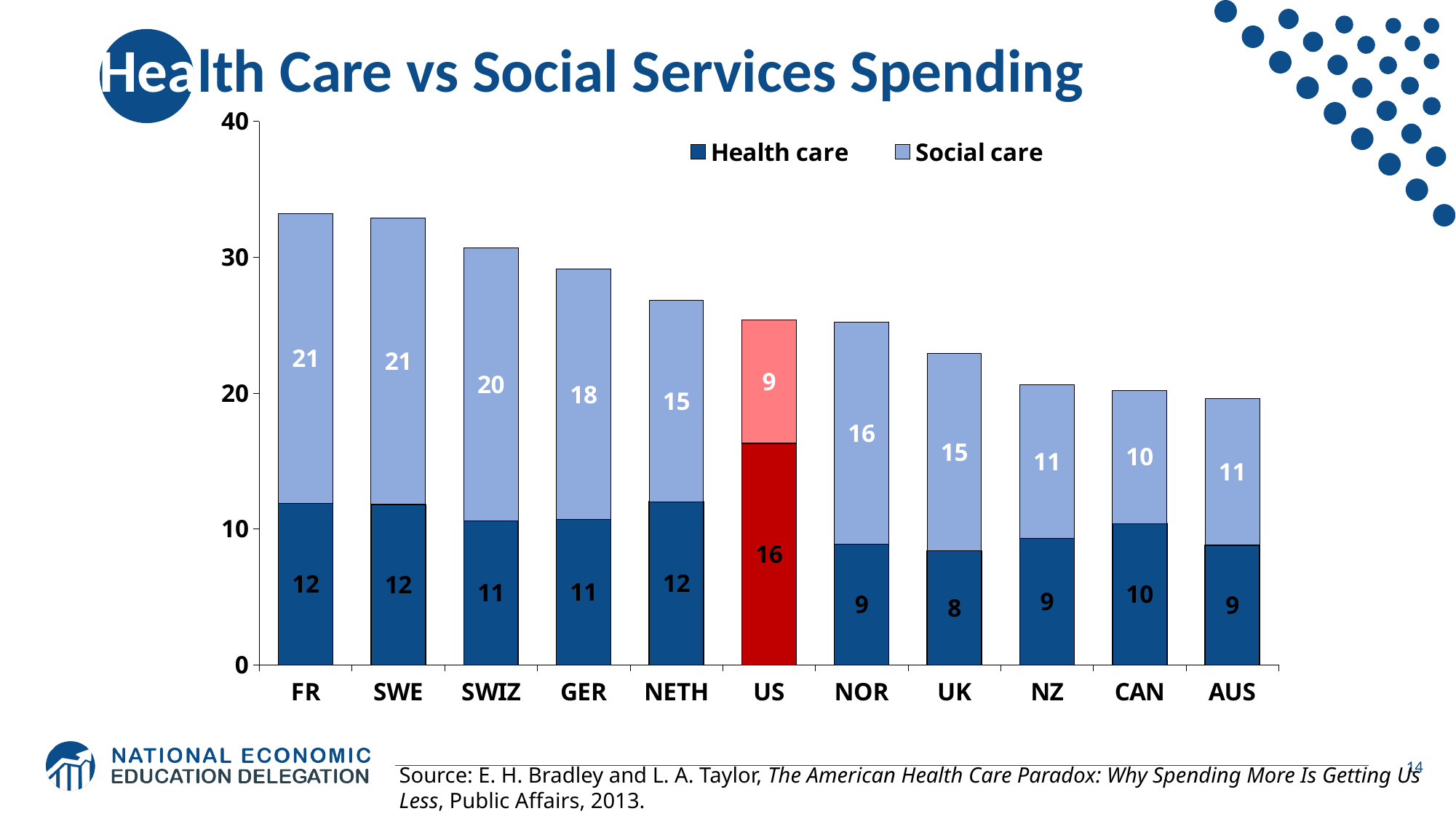
Which country has the lowest Health care value? UK What is the Social care value for Germany (GER)? 18 What is the total of the stacked bar for the US (Health care plus Social care)? 25 How many countries are shown on the x axis? 11 Which is larger, the Social care value for France (FR) or the Social care value for the US? France (FR) Which country has the lowest Social care value? US Is the total height of the FR bar greater or less than 30? greater How many series does the legend list? 2 Which country has the highest Health care value? US What is the difference between the Health care value for the US and the Health care value for the UK? 8 What is the Health care value for the US? 16 What kind of chart is shown on the slide? Stacked bar chart